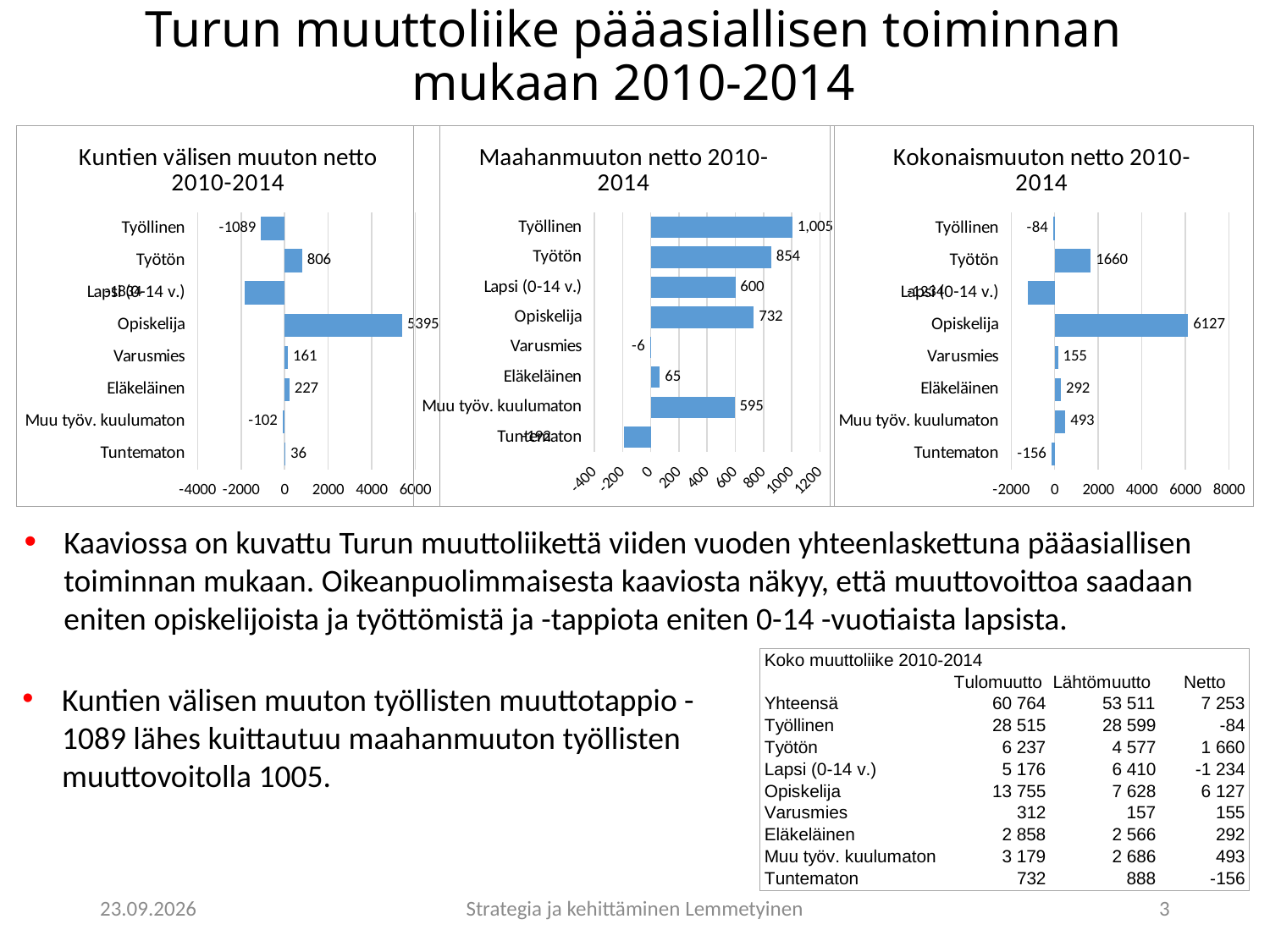
In the chart 'Kokonaismuuton netto 2010-2014', which is larger, the value for Eläkeläinen or the value for Muu työv. kuulumaton? Muu työv. kuulumaton How many categories are shown in the chart 'Kuntien välisen muuton netto 2010-2014'? 8 In the chart 'Maahanmuuton netto 2010-2014', what is the value for Työllinen? 1,005 In the chart 'Maahanmuuton netto 2010-2014', what is the difference between the values for Työtön and Opiskelija? 122 In the chart 'Kuntien välisen muuton netto 2010-2014', what is the value for Työllinen? -1089 In the chart 'Kokonaismuuton netto 2010-2014', is the value for Opiskelija greater or less than 6000? greater In the chart 'Maahanmuuton netto 2010-2014', which category has the lowest value? Tuntematon In the chart 'Kuntien välisen muuton netto 2010-2014', what is the value for Opiskelija? 5395 In the chart 'Kokonaismuuton netto 2010-2014', what is the value for Työtön? 1660 In the chart 'Kuntien välisen muuton netto 2010-2014', what is the difference between the values for Eläkeläinen and Varusmies? 66 In the chart 'Kokonaismuuton netto 2010-2014', which category has the highest value? Opiskelija What kind of chart is 'Maahanmuuton netto 2010-2014'? Bar chart